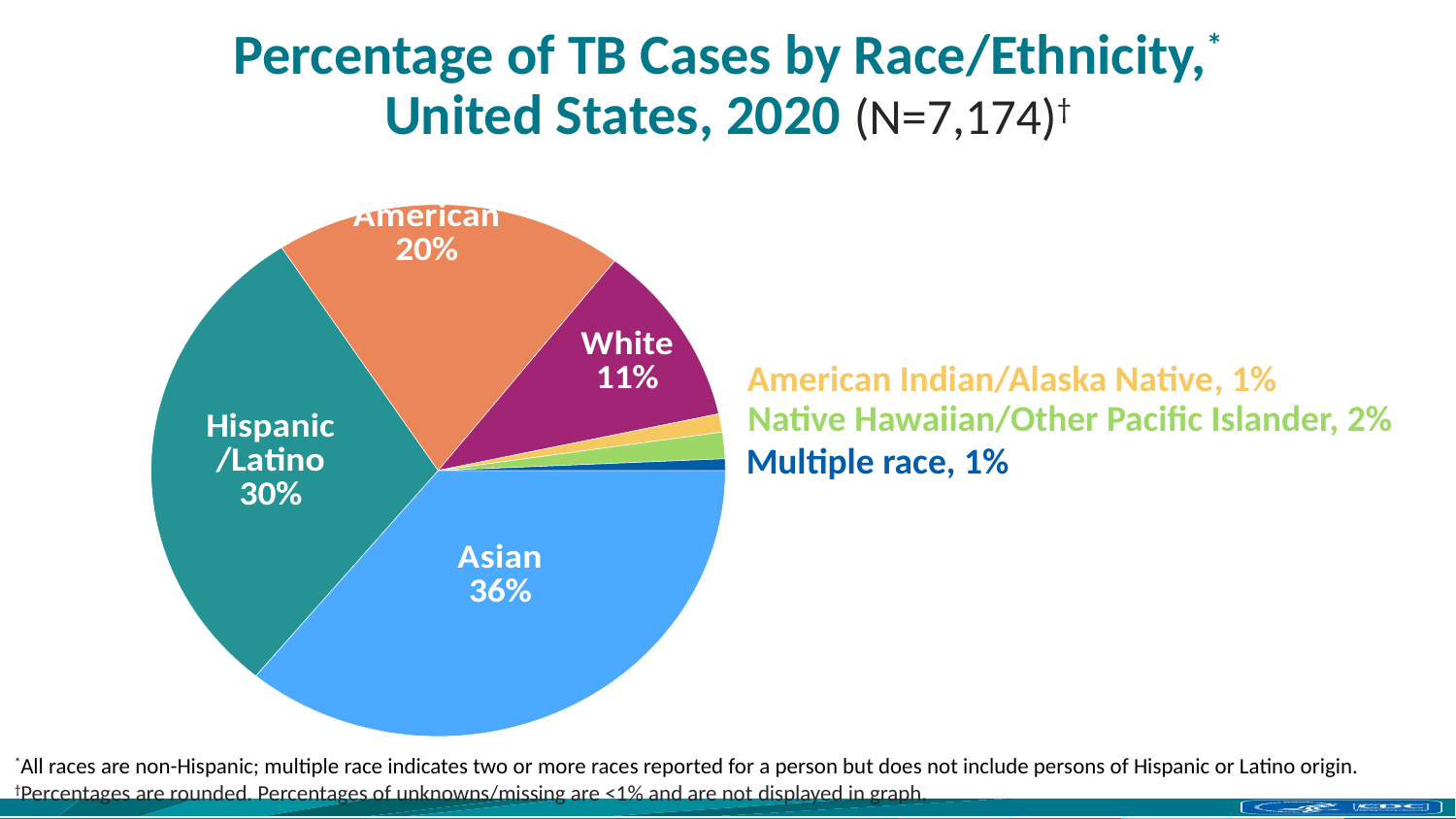
What is the difference in percentage points between the Asian and Hispanic/Latino shares? 6 percentage points Which has a larger share of TB cases, Hispanic/Latino or White? Hispanic/Latino What percentage of TB cases is shown for Native Hawaiian/Other Pacific Islander? 2% Which race/ethnicity group has the largest share of TB cases? Asian What percentage of TB cases is shown for Hispanic/Latino? 30% What kind of chart is shown on the slide? pie chart Which has a larger share of TB cases, Native Hawaiian/Other Pacific Islander or Multiple race? Native Hawaiian/Other Pacific Islander What is the total number of TB cases (N) given in the chart title? 7,174 How many slices does the pie chart have? 7 What percentage of TB cases is shown for Multiple race? 1% What percentage of TB cases is shown for Asian? 36% What percentage of TB cases is shown for White? 11%